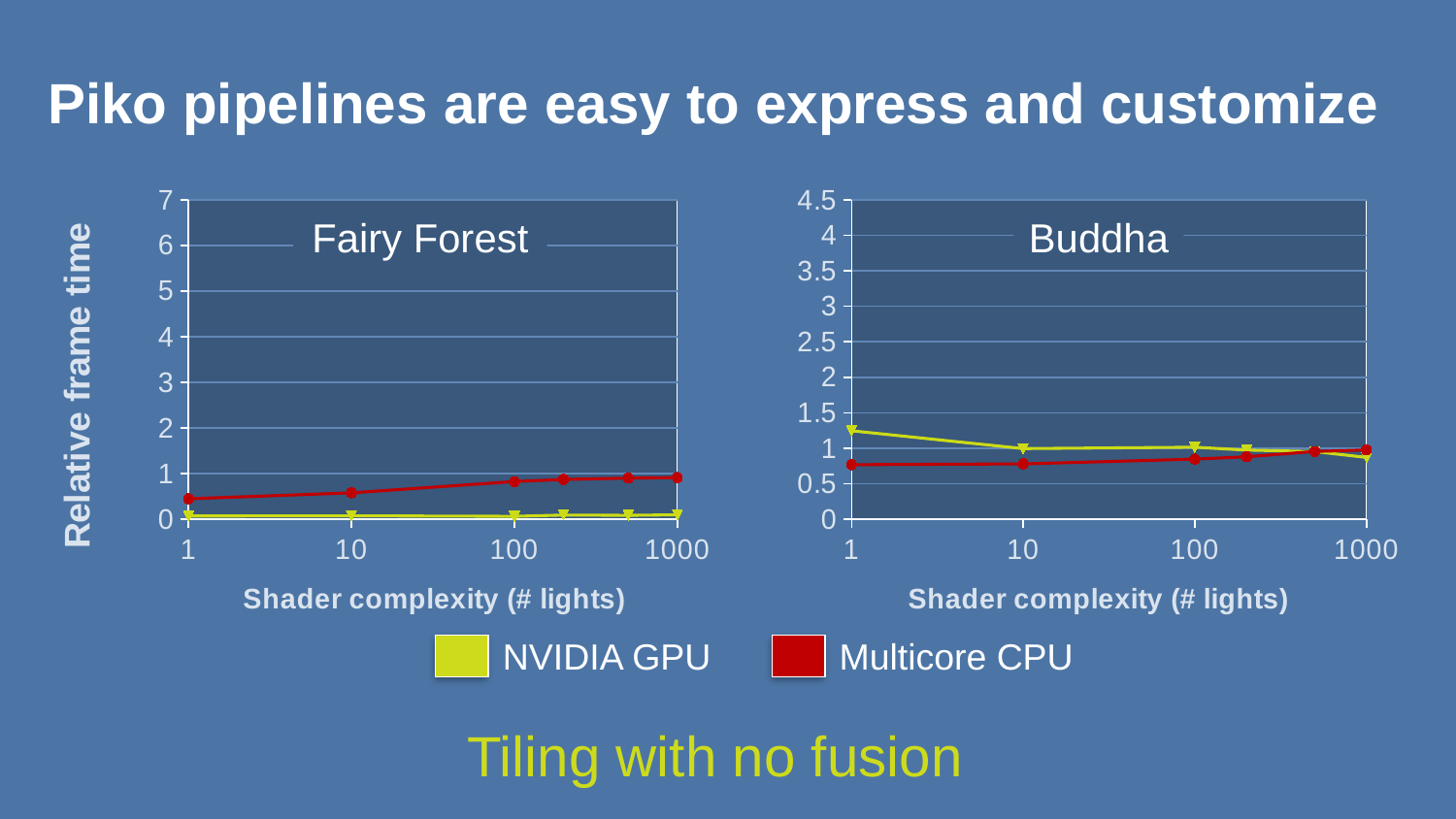
How many labelled tick values are on the x axis of the Buddha chart? 4 What kind of chart is the Fairy Forest chart? line chart In the Buddha chart, does the NVIDIA GPU line rise or fall between 1 and 10 lights? fall Which legend entry is shown in red? Multicore CPU In the Fairy Forest chart, does the Multicore CPU line rise or fall as shader complexity increases from 1 to 1000 lights? rise In the Buddha chart, is the NVIDIA GPU value at 1 light greater or less than 1? greater In the Fairy Forest chart, which series has the higher value at 1 light, NVIDIA GPU or Multicore CPU? Multicore CPU What is the x-axis label of the Fairy Forest chart? Shader complexity (# lights) How many series does the legend list? 2 In the Buddha chart, which series has the higher value at 1 light, NVIDIA GPU or Multicore CPU? NVIDIA GPU In the Buddha chart, is the Multicore CPU value at 1 light greater or less than 1? less